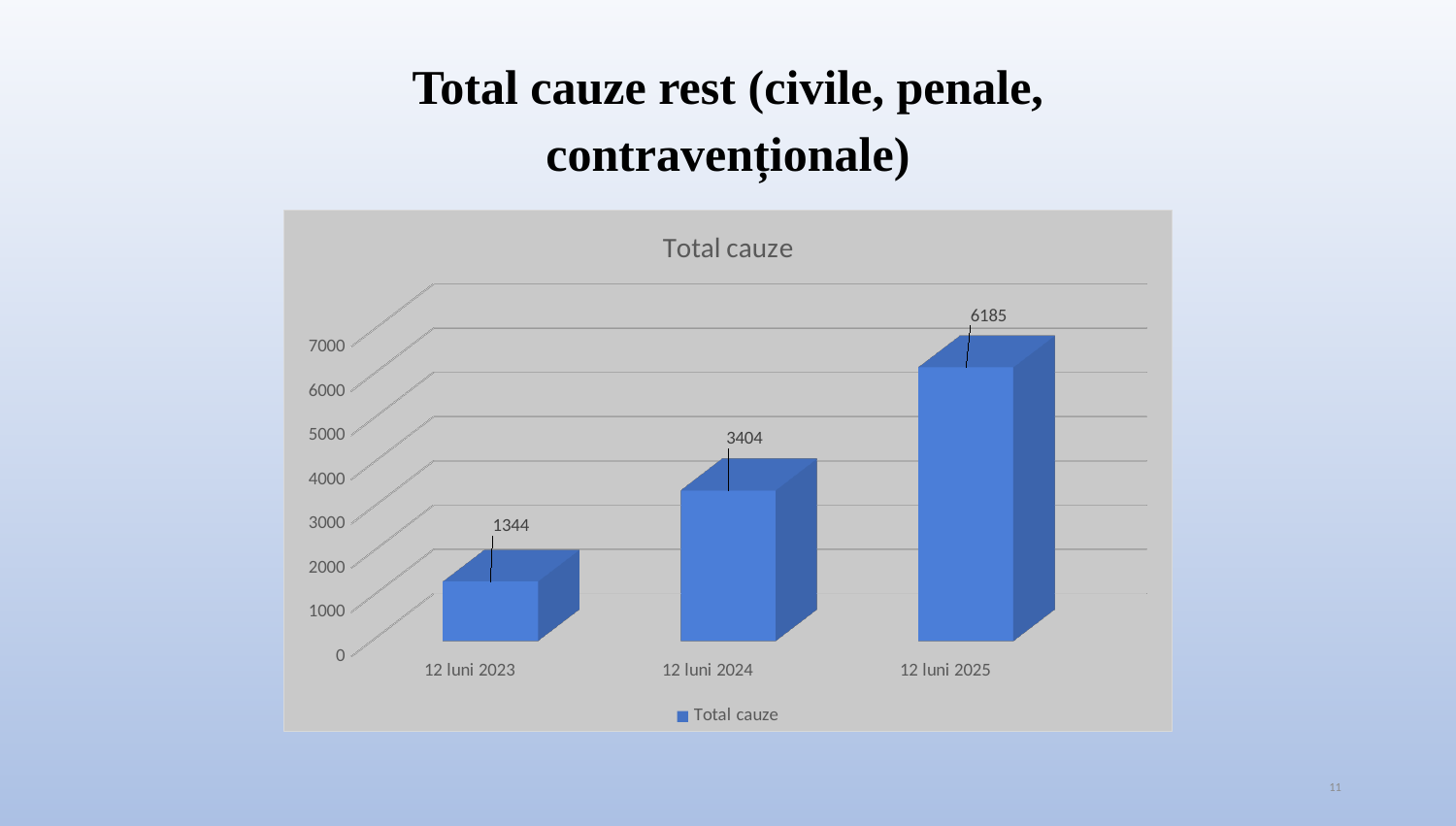
How many categories are shown on the x axis? 3 Is the value for 12 luni 2025 greater or less than 5000? greater Which category has the lowest value? 12 luni 2023 What is the value for 12 luni 2023? 1344 What is the difference between the values for 12 luni 2024 and 12 luni 2023? 2060 What kind of chart is shown? bar chart Do the values rise or fall from 12 luni 2023 to 12 luni 2025? rise What is the value for 12 luni 2024? 3404 Which category has the highest value? 12 luni 2025 What is the value for 12 luni 2025? 6185 Which is larger, the value for 12 luni 2024 or the value for 12 luni 2023? 12 luni 2024 What is the difference between the values for 12 luni 2025 and 12 luni 2024? 2781